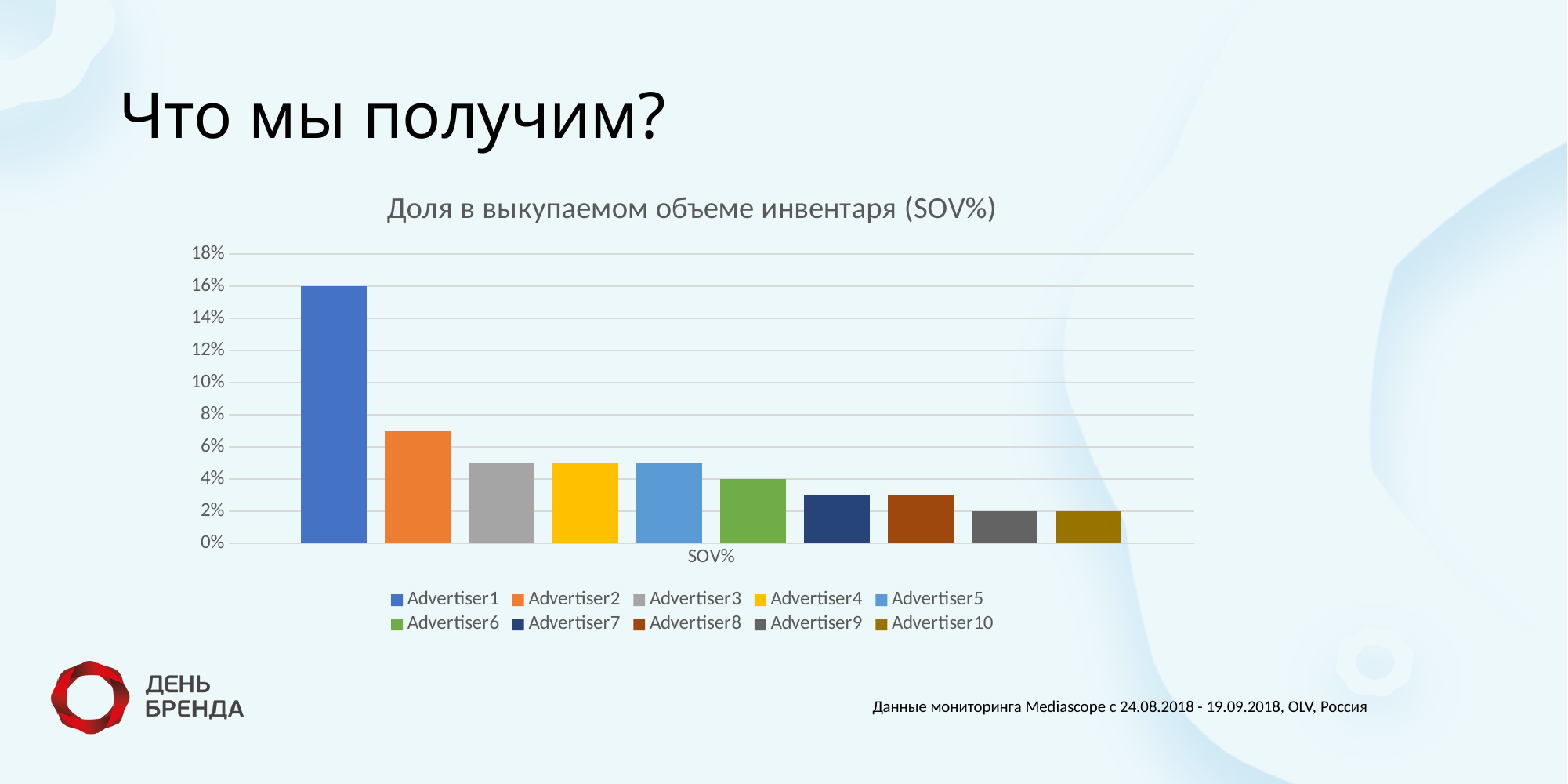
What kind of chart is shown on the slide? bar chart Is the value for Advertiser7 greater or less than 4%? less What is the difference between the values for Advertiser1 and Advertiser9? 14% How many series does the legend list? 10 What is the difference between the values for Advertiser1 and Advertiser6? 12% Is the value for Advertiser2 greater or less than 6%? greater What is the value for Advertiser1 in the chart? 16% What is the value for Advertiser6 in the chart? 4% Which is larger, the value for Advertiser2 or the value for Advertiser6? Advertiser2 What is the title of the chart? Доля в выкупаемом объеме инвентаря (SOV%) Which advertiser has the highest share in the chart? Advertiser1 What is the value for Advertiser9 in the chart? 2%